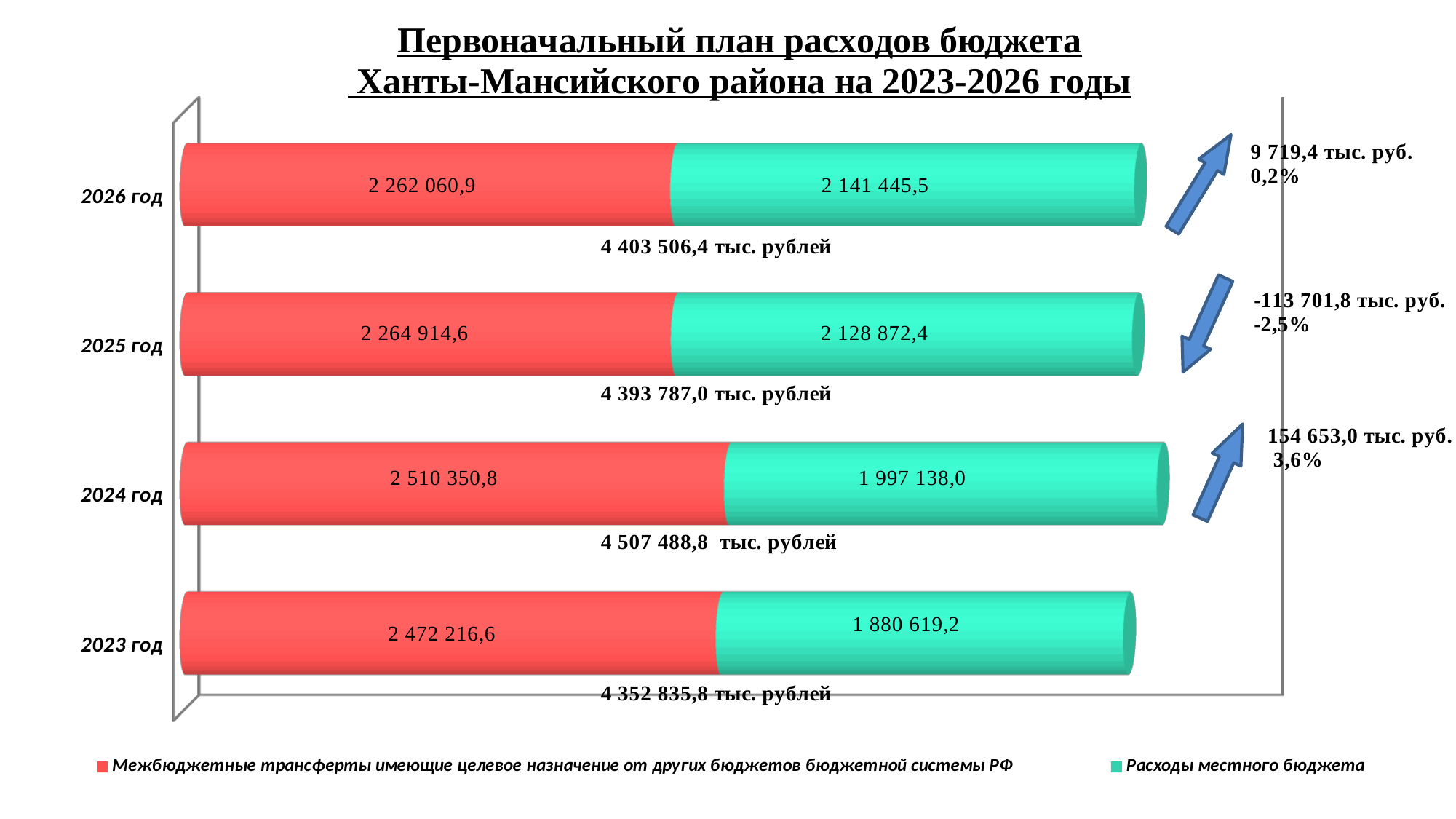
How many years are shown on the chart? 4 What is the value of «Расходы местного бюджета» for 2026 год? 2 141 445,5 What is the difference between «Межбюджетные трансферты» and «Расходы местного бюджета» for 2023 год? 591 597,4 Which year has the lowest value for «Расходы местного бюджета»? 2023 год Which year has the highest value for «Межбюджетные трансферты имеющие целевое назначение от других бюджетов бюджетной системы РФ»? 2024 год What is the value of «Межбюджетные трансферты имеющие целевое назначение от других бюджетов бюджетной системы РФ» for 2024 год? 2 510 350,8 What kind of chart is shown on the slide? Stacked bar chart What is the value of «Расходы местного бюджета» for 2023 год? 1 880 619,2 How many series does the legend list? 2 What is the total of the stacked bar for 2024 год? 4 507 488,8 тыс. рублей Does the value of «Расходы местного бюджета» rise or fall from 2023 год to 2026 год? Rise Which is larger for 2025 год: «Межбюджетные трансферты» or «Расходы местного бюджета»? Межбюджетные трансферты